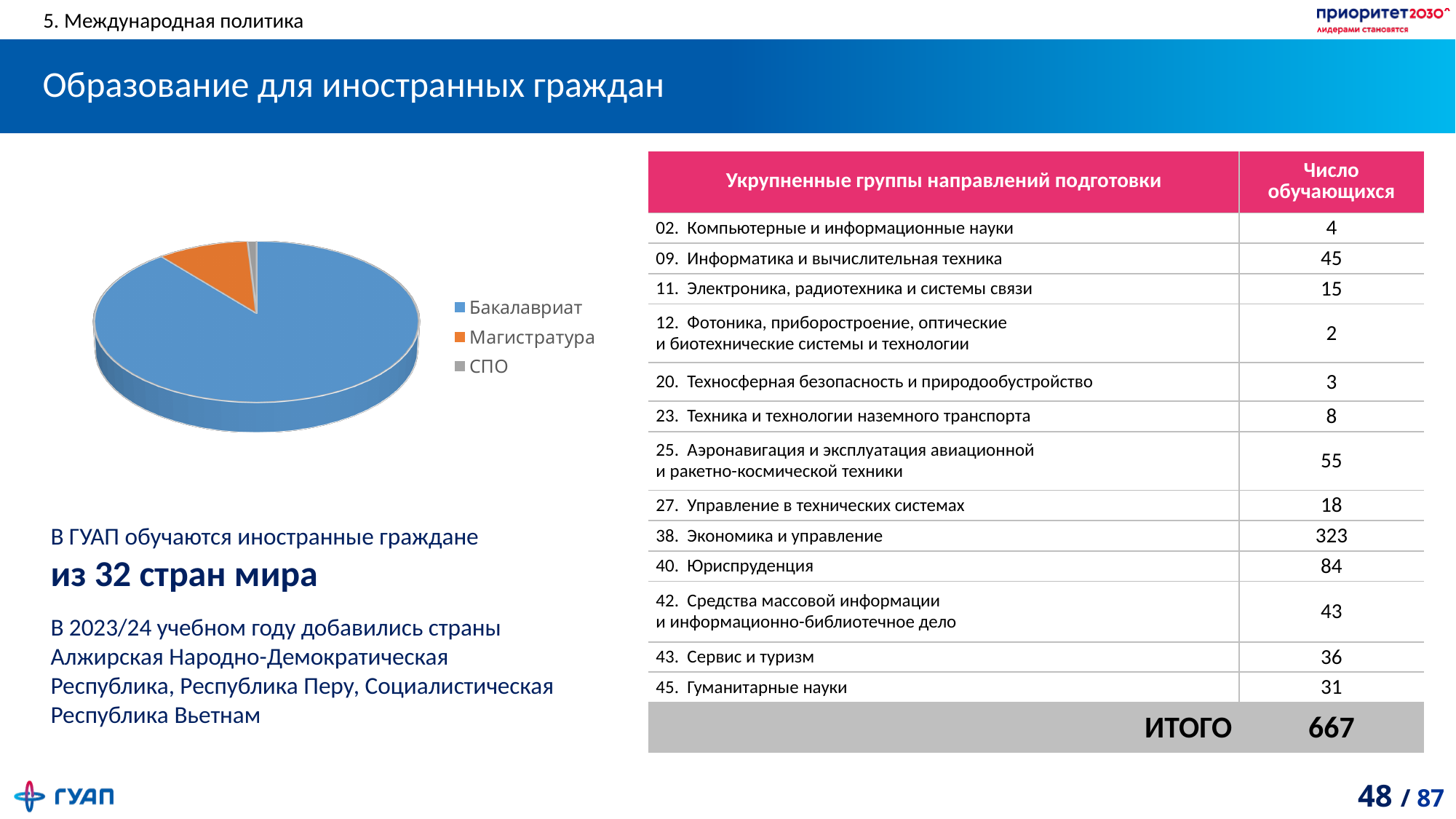
In the pie chart, which slice is larger: Бакалавриат or Магистратура? Бакалавриат Which category has the largest slice in the pie chart? Бакалавриат How many categories does the legend of the pie chart list? 3 Does the Бакалавриат slice take up more or less than half of the pie chart? more In the pie chart, which slice is larger: Магистратура or СПО? Магистратура Which category has the smallest slice in the pie chart? СПО What colour is the Магистратура slice in the pie chart? orange What kind of chart is shown on the left of the slide? pie chart Which legend entry of the pie chart is shown in blue? Бакалавриат How many slices does the pie chart have? 3